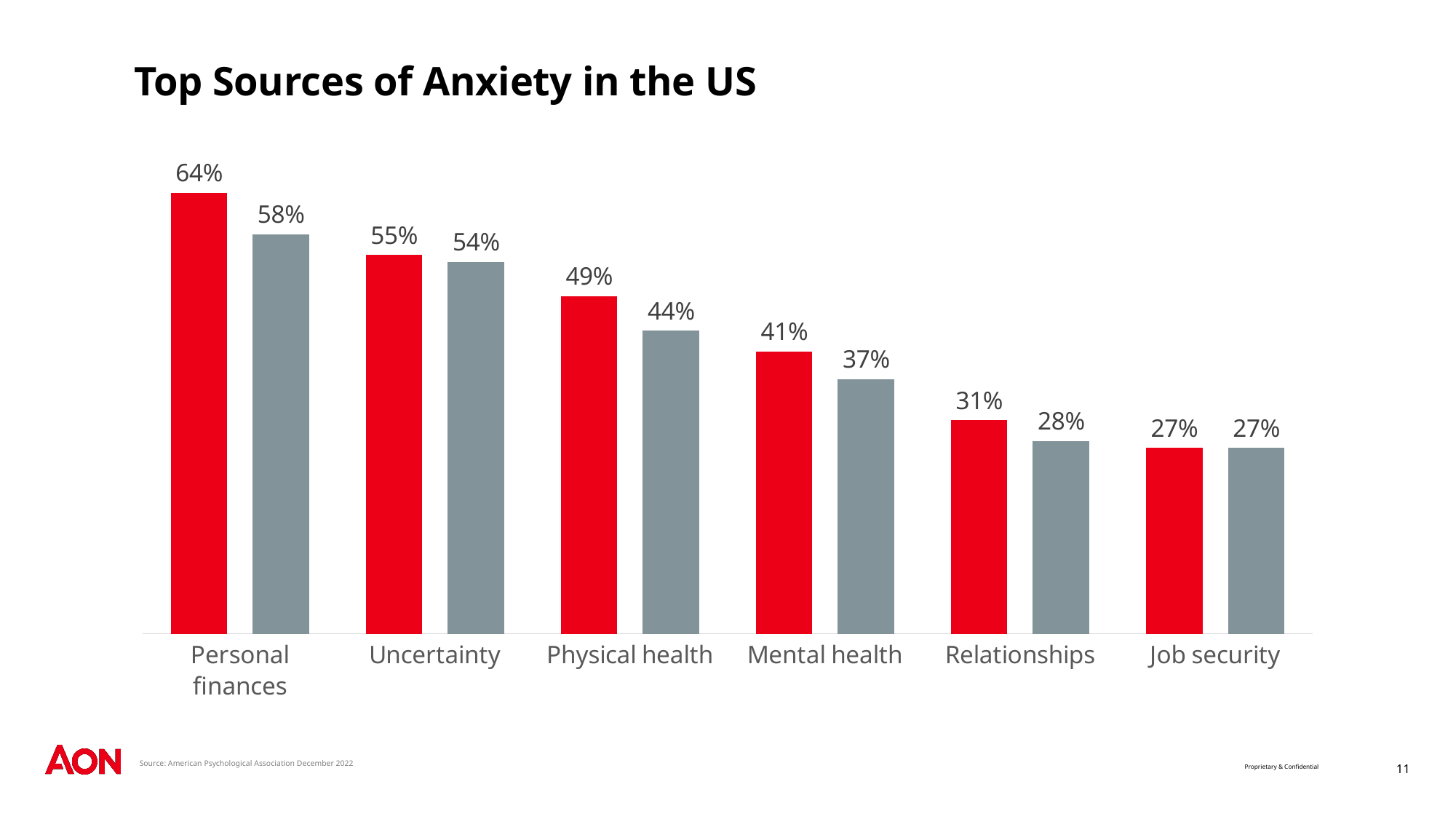
What is the difference between the red bar for Personal finances and the red bar for Uncertainty? 9% What kind of chart is shown on the slide? Bar chart Which is larger, the red bar for Mental health or the grey bar for Physical health? Grey bar for Physical health Do the red bar values rise or fall from left to right along the x axis? Fall What is the value of the grey bar for Relationships? 28% What is the difference between the red and grey bars for Physical health? 5% What is the value of the red bar for Mental health? 41% How many categories are shown on the x axis? 6 What is the value of the red bar for Personal finances? 64% Which category has the highest red bar? Personal finances Which category has the lowest grey bar? Job security What is the value of the grey bar for Uncertainty? 54%